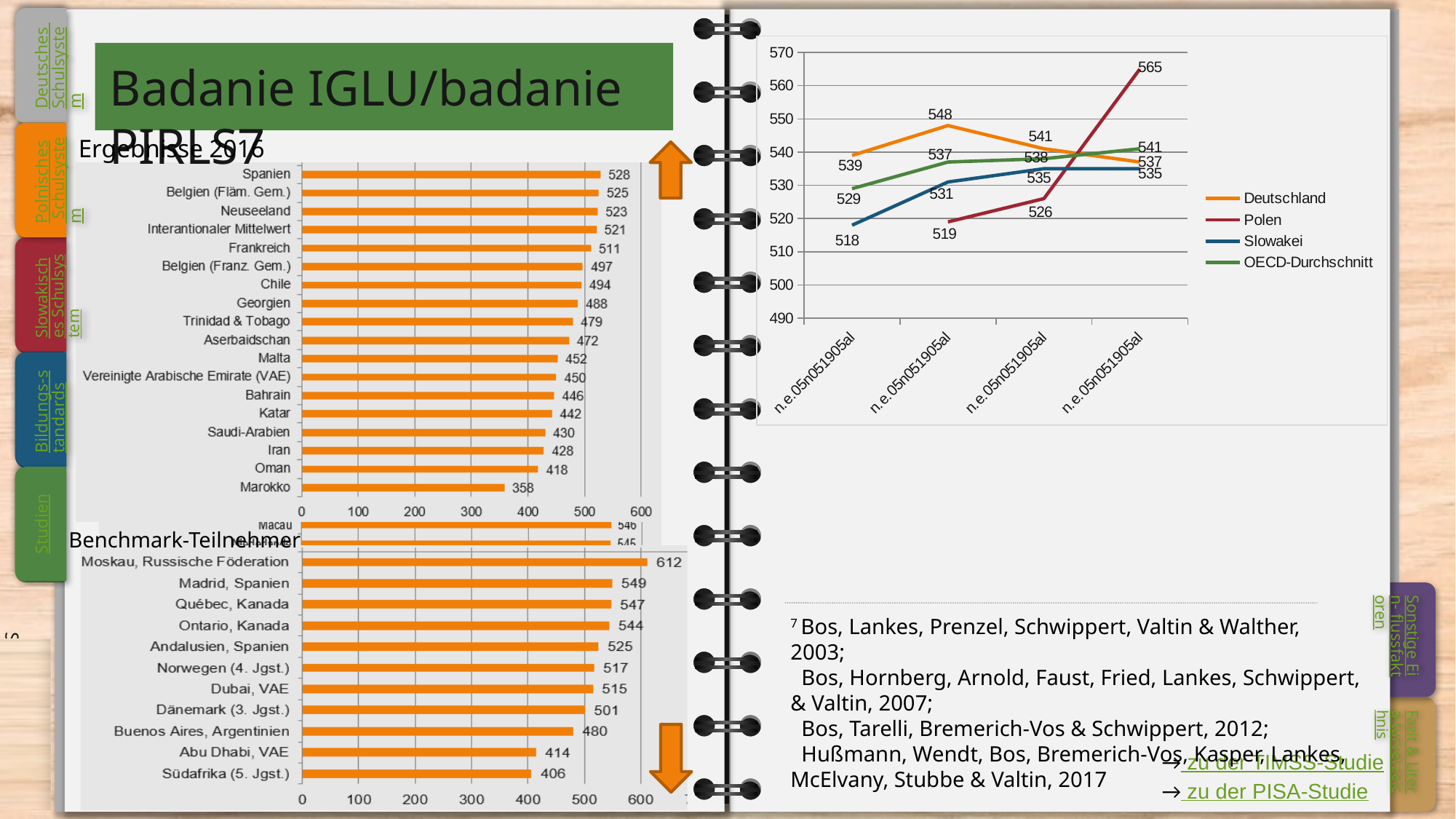
In the 'Benchmark-Teilnehmer' bar chart at the bottom left, which participant has the highest value? Moskau, Russische Föderation What kind of chart is the 'Benchmark-Teilnehmer' chart at the bottom left? Bar chart In the line chart on the right, which series has the highest value at the rightmost point? Polen In the 'Ergebnisse 2016' bar chart on the left, what is the value for Internationaler Mittelwert? 521 In the line chart on the right, what is the last (rightmost) value for Polen? 565 In the 'Benchmark-Teilnehmer' bar chart at the bottom left, what is the value for Südafrika (5. Jgst.)? 406 How many series does the legend of the line chart on the right list? 4 In the 'Ergebnisse 2016' bar chart on the left, which country has the lowest value? Marokko In the line chart on the right, what is the highest value shown for Deutschland? 548 In the line chart on the right, what is the difference between the last value for Polen (565) and the last value for Deutschland (537)? 28 In the line chart on the right, what colour is the line for OECD-Durchschnitt? Green In the 'Ergebnisse 2016' bar chart on the left, what is the value for Spanien? 528